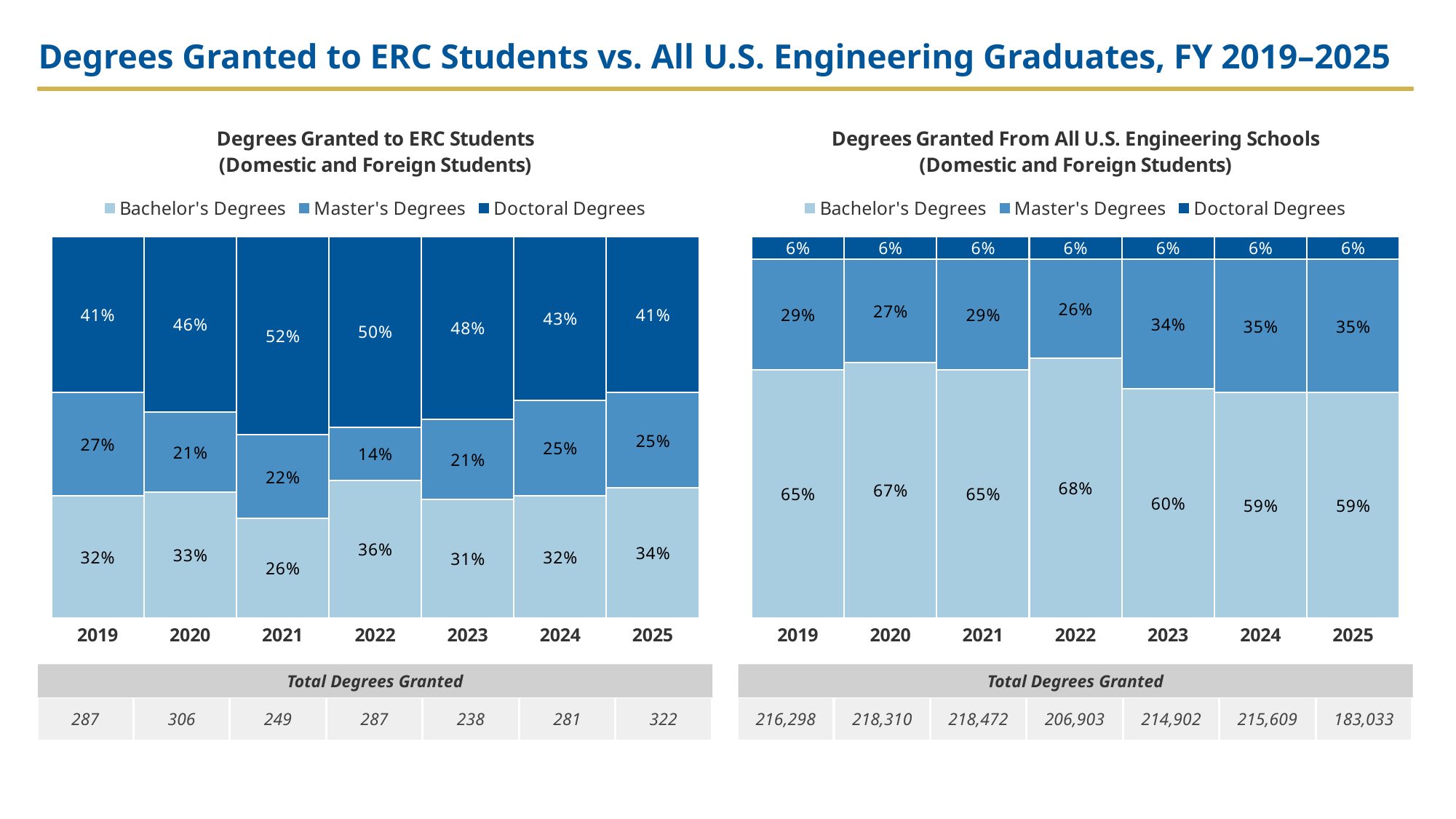
How many years are shown on the x axis of the 'Degrees Granted to ERC Students' chart? 7 In the 'Degrees Granted to ERC Students' chart, what percentage of degrees in 2022 were Bachelor's Degrees? 36% In the 'Degrees Granted From All U.S. Engineering Schools' chart, is the Bachelor's Degrees share larger in 2020 or in 2023? 2020 In the 'Degrees Granted From All U.S. Engineering Schools' chart, what is the Doctoral Degrees share in every year shown? 6% How many series does the legend of the 'Degrees Granted From All U.S. Engineering Schools' chart list? 3 In the 'Degrees Granted to ERC Students' chart, what is the difference between the Doctoral Degrees share in 2021 and in 2025? 11 percentage points In the 'Degrees Granted to ERC Students' chart, what percentage of degrees in 2021 were Doctoral Degrees? 52% What kind of chart is the 'Degrees Granted to ERC Students' chart? Stacked bar chart In the 'Degrees Granted From All U.S. Engineering Schools' chart, which year has the highest Bachelor's Degrees share? 2022 In the 'Degrees Granted From All U.S. Engineering Schools' chart, what percentage of degrees in 2024 were Master's Degrees? 35% In the 'Degrees Granted to ERC Students' chart, which year has the highest Doctoral Degrees share? 2021 In the 'Degrees Granted to ERC Students' chart, which year has the lowest Master's Degrees share? 2022